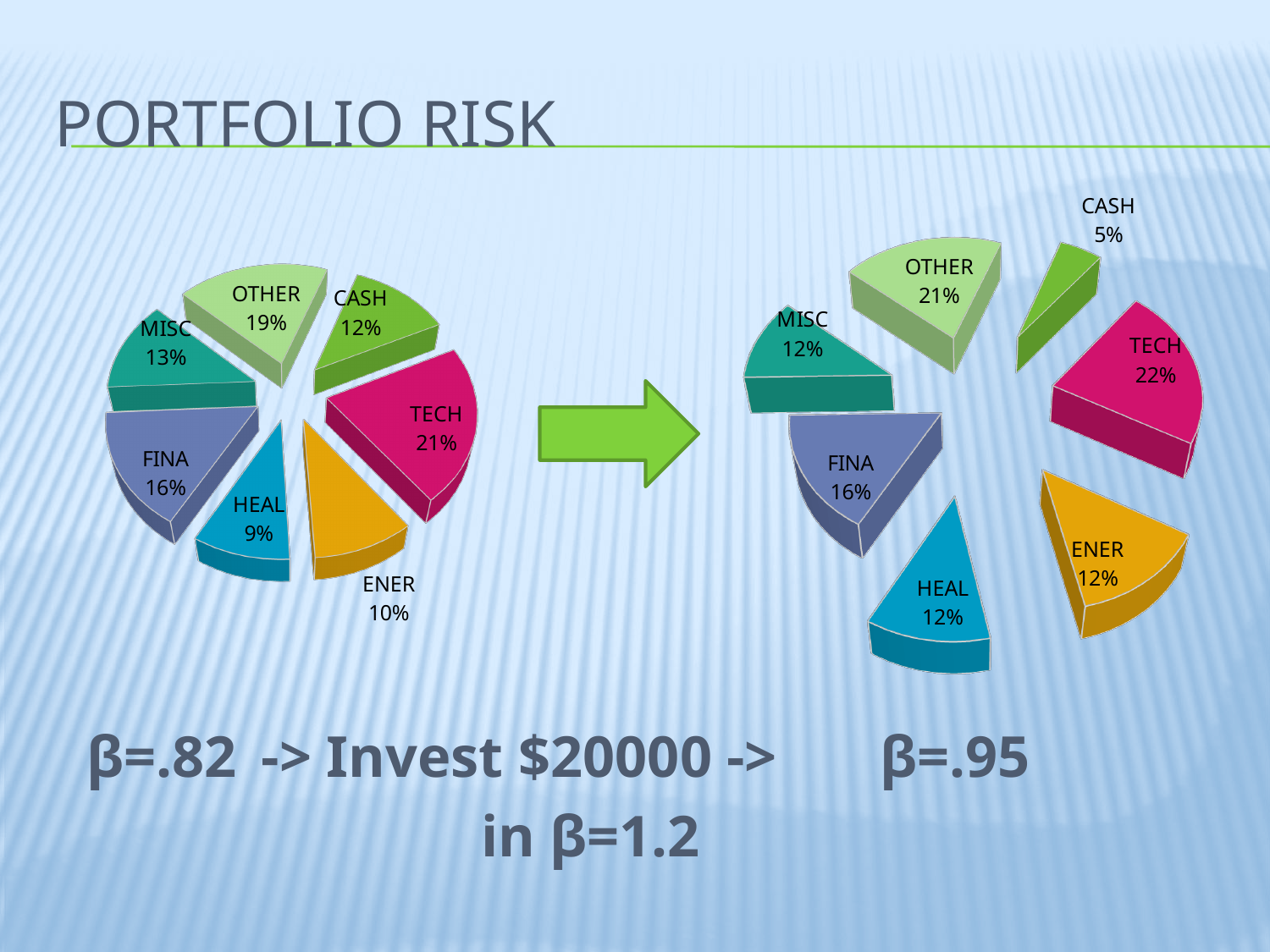
What is the title of the slide containing the two pie charts? PORTFOLIO RISK In the left pie chart, what share does TECH have? 21% In the right pie chart, which is larger, the OTHER share or the FINA share? OTHER In the right pie chart, which category has the largest share? TECH In the left pie chart, what is the difference between the OTHER share and the ENER share? 9% In the right pie chart, which category has the smallest share? CASH What kind of chart is shown on the right side of the slide? Pie chart How many slices does the left pie chart have? 7 In the right pie chart, what share does CASH have? 5% In the left pie chart, which category has the smallest share? HEAL In the left pie chart, which category has the largest share? TECH In the left pie chart, what share does FINA have? 16%